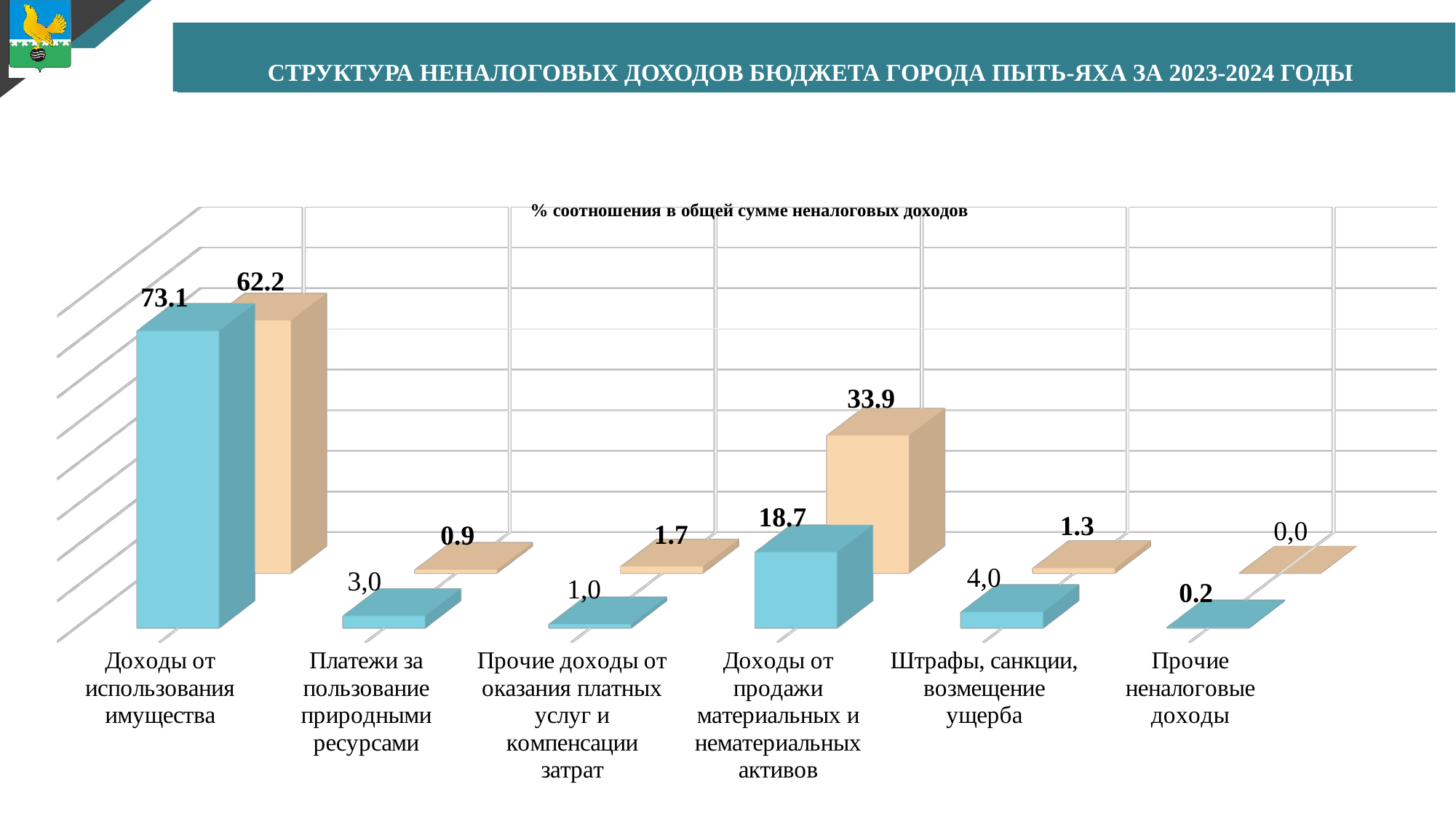
Which category has the lowest value among the beige bars? Прочие неналоговые доходы How many categories are shown on the x axis of the chart? 6 Which category has the highest value among the blue bars? Доходы от использования имущества For "Доходы от продажи материальных и нематериальных активов", which bar is larger, the blue or the beige one? beige What is the title of the chart? % соотношения в общей сумме неналоговых доходов What type of chart is shown on the slide? bar chart What is the value of the beige bar for "Доходы от продажи материальных и нематериальных активов"? 33.9 What is the difference between the blue and beige bars for "Доходы от использования имущества"? 10.9 What is the value of the blue bar for "Штрафы, санкции, возмещение ущерба"? 4,0 What is the value of the blue bar for "Доходы от использования имущества"? 73.1 What is the value of the beige bar for "Доходы от использования имущества"? 62.2 What is the value of the beige bar for "Прочие неналоговые доходы"? 0,0